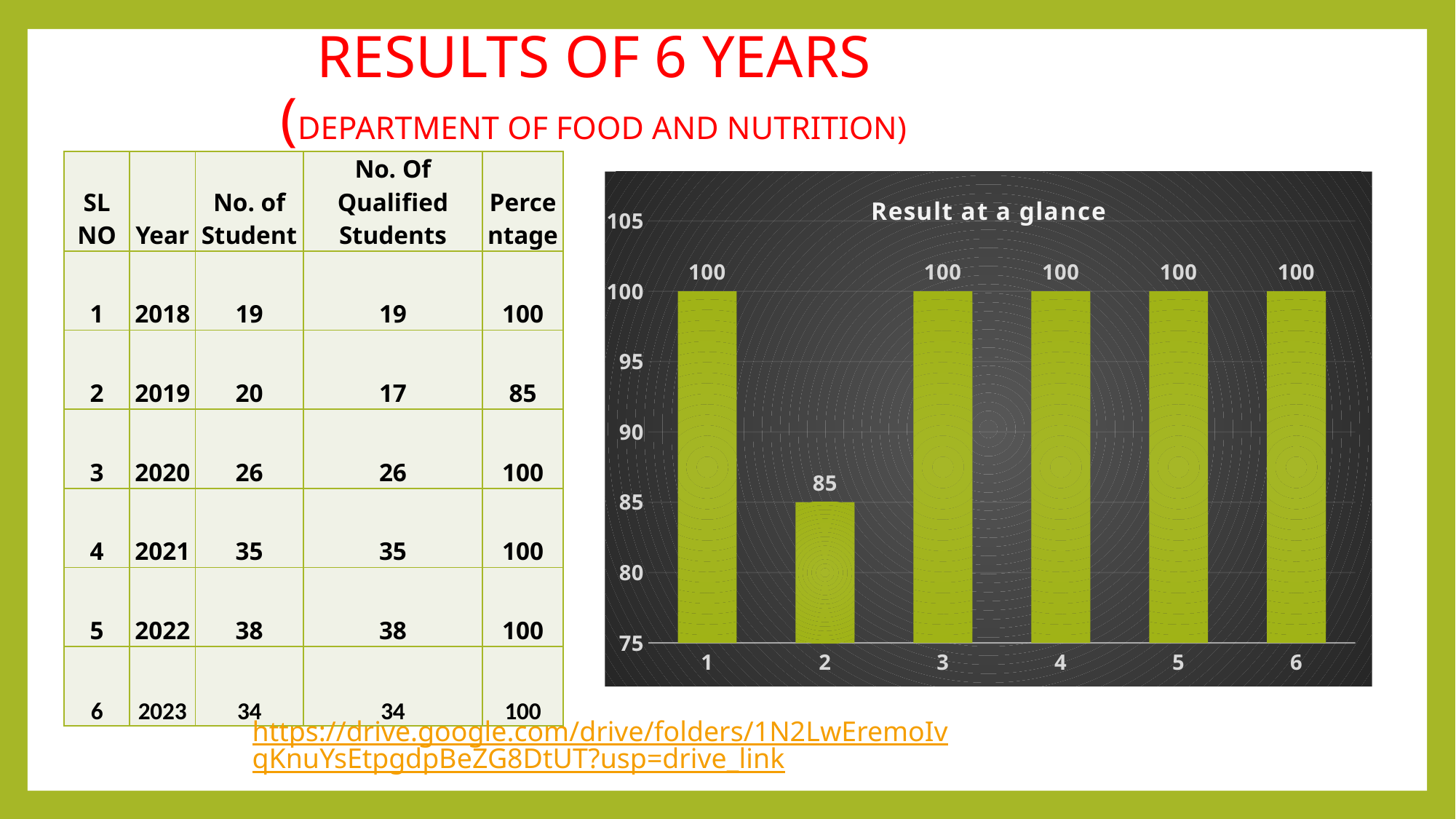
What is the value of the bar for category 2? 85 What colour are the bars in the chart? green What type of chart is shown on the slide? bar chart How many bars in the chart have a value of 100? 5 What is the title of the chart? Result at a glance Which is larger, the value for category 2 or the value for category 3? category 3 Is the value for category 2 greater or less than 90? less Which category has the lowest value in the chart? 2 What is the difference between the values for category 1 and category 2? 15 What is the value of the bar for category 4? 100 Is the value for category 5 greater or less than 95? greater How many bars are plotted in the chart? 6